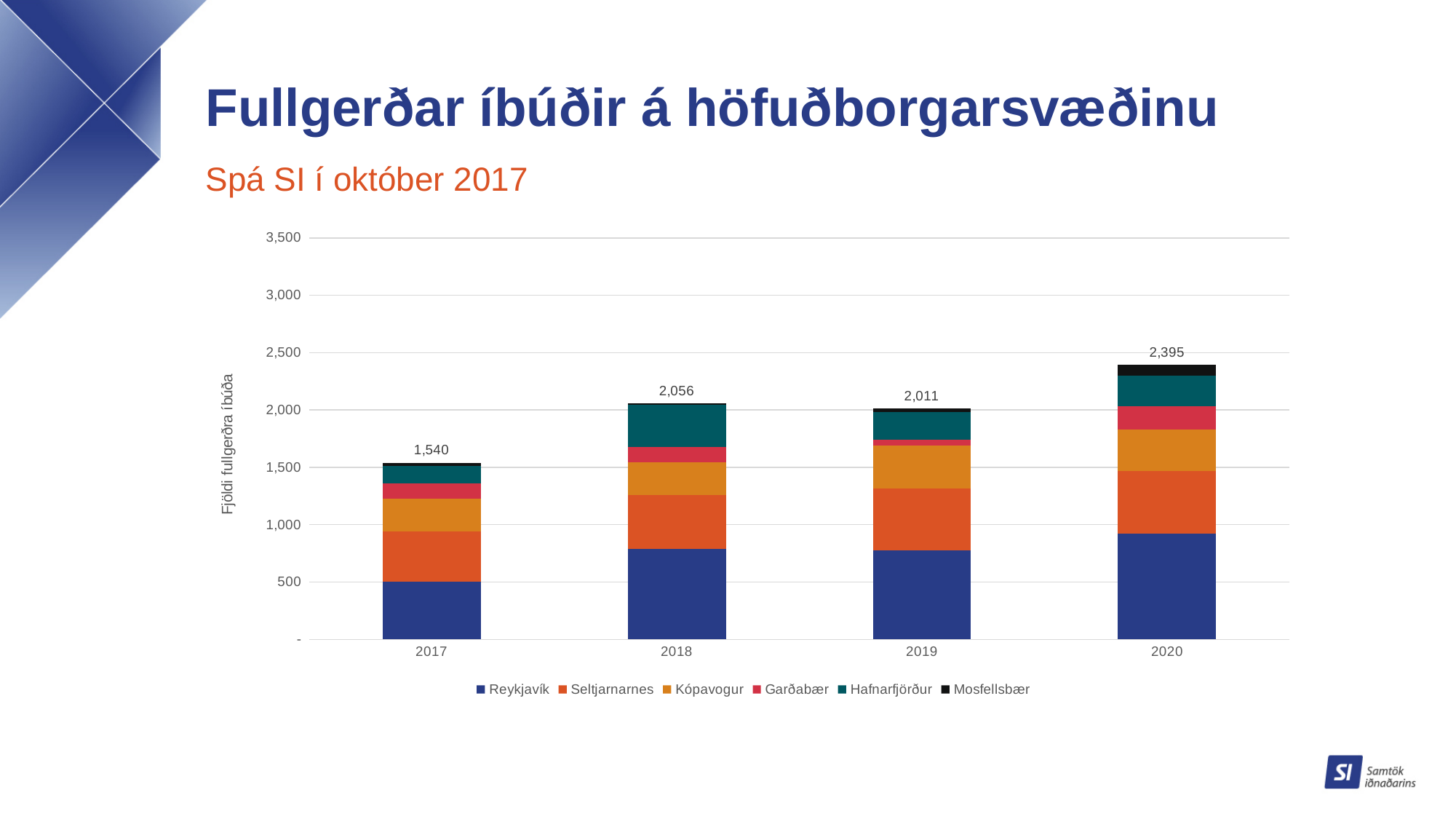
What is the total value labelled on the 2020 bar? 2,395 What is the total number of completed apartments shown for 2017? 1,540 What kind of chart is shown on the slide? Stacked bar chart What is the difference between the 2020 total and the 2017 total? 855 Is the Reykjavík value for 2020 greater or less than 1,000? less How many series does the legend list? 6 What is the total value labelled on the 2018 bar? 2,056 Which year has the larger total, 2018 or 2019? 2018 Which year has the lowest total? 2017 How many years are shown on the x axis? 4 What is the difference between the 2018 total and the 2019 total? 45 Which year has the highest total? 2020